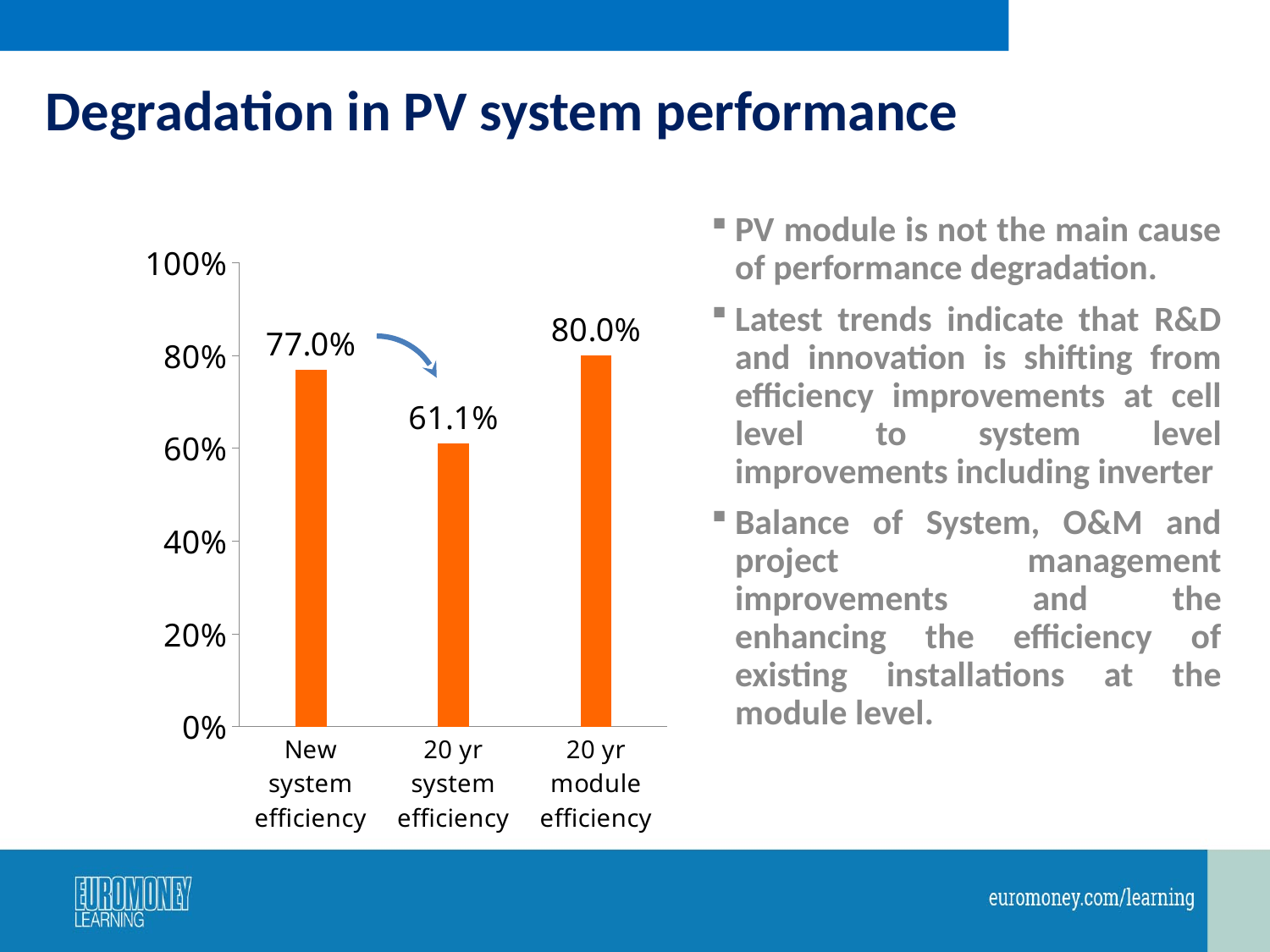
How many categories are shown in the chart? 3 What is the value for 20 yr system efficiency? 61.1% Is the value for 20 yr system efficiency greater or less than 80%? less What is the difference between New system efficiency and 20 yr system efficiency? 15.9% What is the value for 20 yr module efficiency? 80.0% Which is larger, New system efficiency or 20 yr system efficiency? New system efficiency What kind of chart is shown on the slide? bar chart Which category has the lowest value? 20 yr system efficiency What is the difference between 20 yr module efficiency and New system efficiency? 3.0% Which category has the highest value? 20 yr module efficiency What is the value for New system efficiency? 77.0% What colour are the bars in the chart? orange